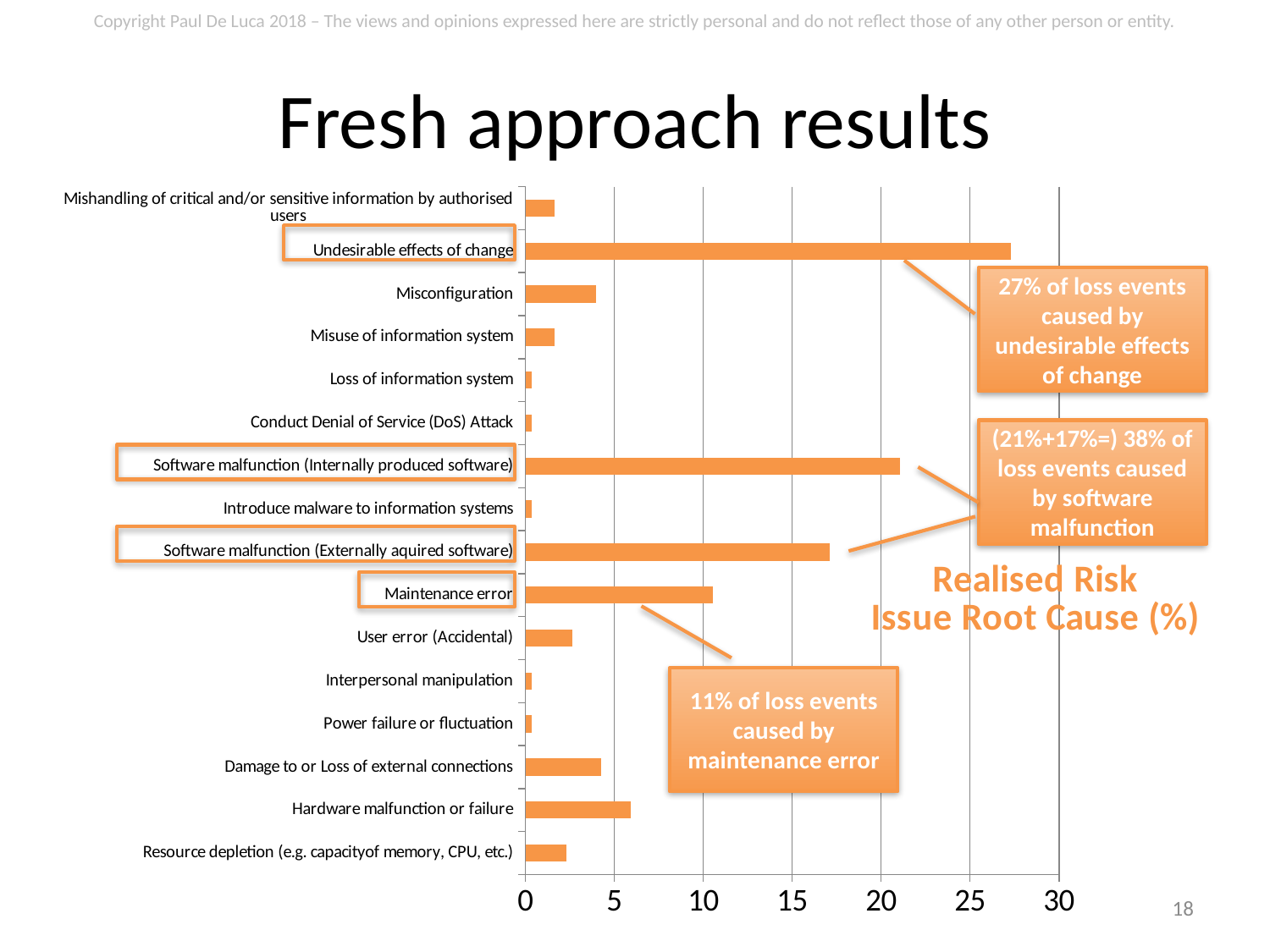
According to the callout, what combined percentage of loss events were caused by software malfunction (internally produced plus externally acquired)? 38% How many categories (root causes) are plotted in the chart? 16 According to the callout, what percentage of loss events were caused by undesirable effects of change? 27% Is the value for Software malfunction (Internally produced software) greater or less than 20? greater What kind of chart is shown on the slide? Bar chart Which root cause has the highest value in the chart? Undesirable effects of change Is the value for Hardware malfunction or failure greater or less than 5? greater What is the title shown on the chart? Realised Risk Issue Root Cause (%) Which is larger: the value for Hardware malfunction or failure or the value for Misconfiguration? Hardware malfunction or failure Is the value for Misconfiguration greater or less than 5? less According to the callout, what percentage of loss events were caused by maintenance error? 11% Which is larger: the value for Undesirable effects of change or the value for Software malfunction (Externally aquired software)? Undesirable effects of change